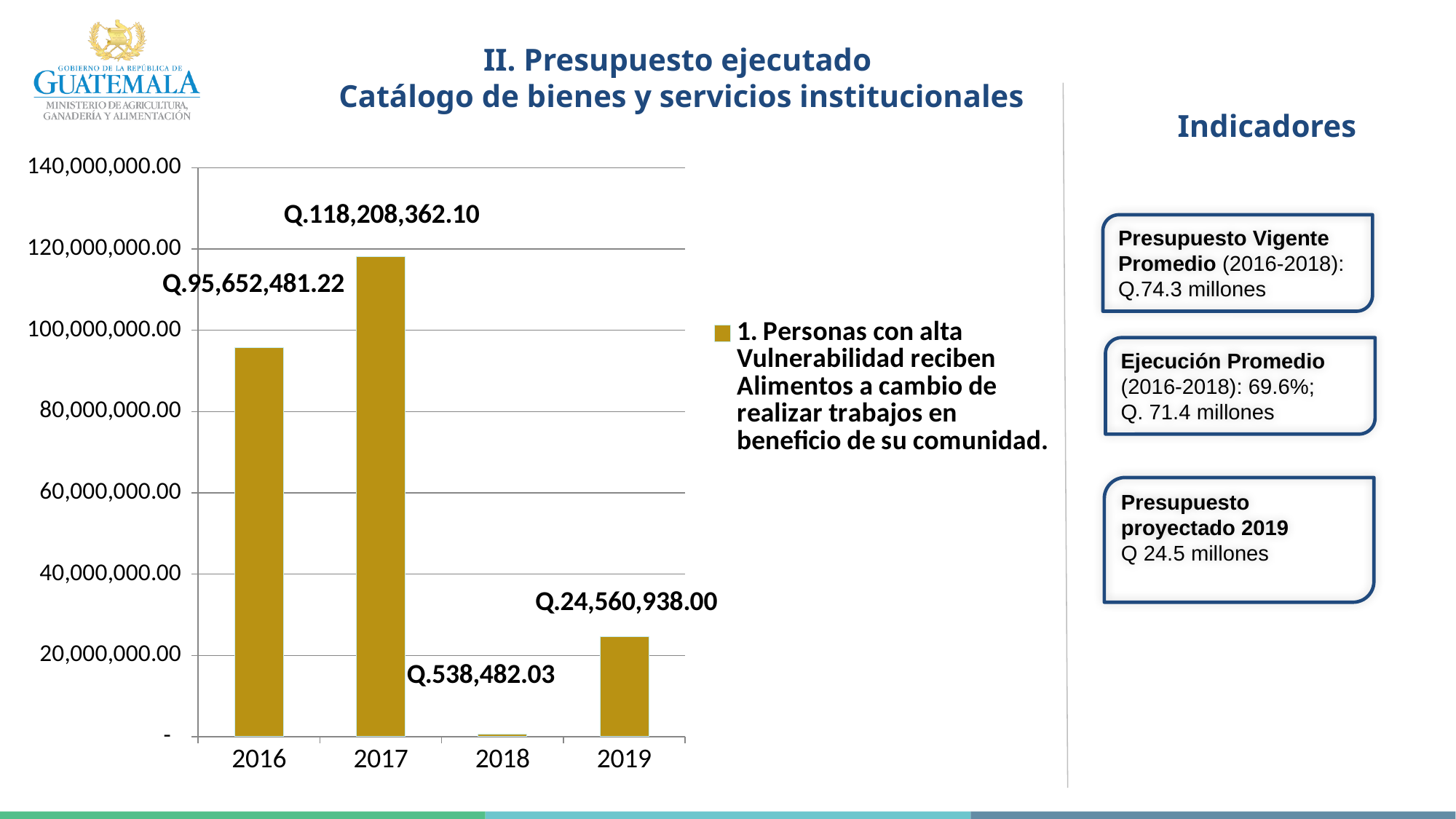
Which year has the lowest value? 2018 What is the value for 2019? Q.24,560,938.00 What is the difference between the values for 2019 and 2018? Q.24,022,455.97 Which is larger, the value for 2016 or the value for 2019? 2016 Is the value for 2019 greater or less than 40,000,000.00? less What is the value for 2016? Q.95,652,481.22 How many years are shown on the x axis? 4 Which year has the highest value? 2017 What is the difference between the values for 2017 and 2016? Q.22,555,880.88 What kind of chart is shown on the slide? bar chart What is the value for 2017? Q.118,208,362.10 What is the value for 2018? Q.538,482.03